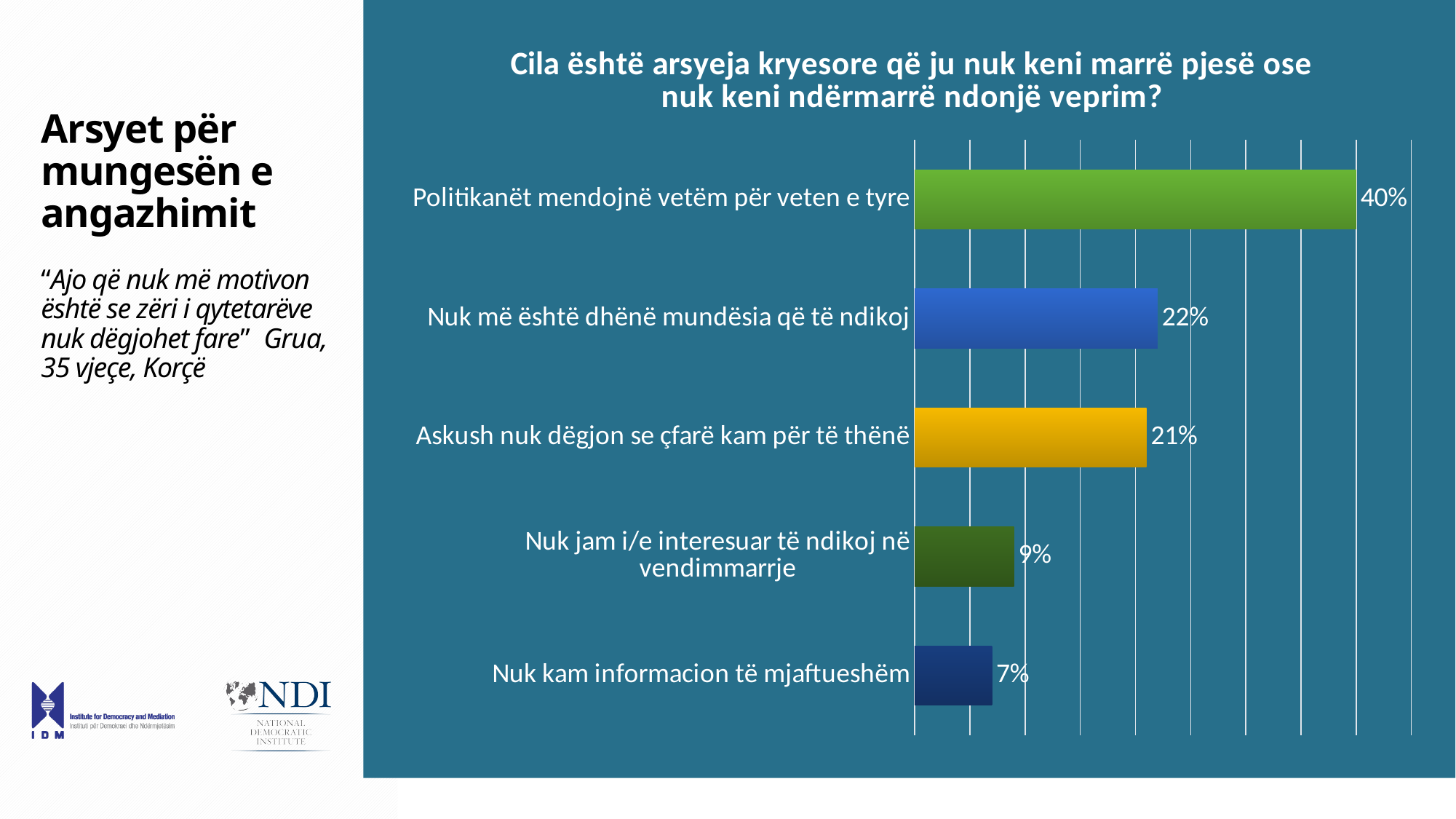
What is the value for "Nuk kam informacion të mjaftueshëm"? 7% Which is larger: the value for "Nuk jam i/e interesuar të ndikoj në vendimmarrje" or the value for "Nuk kam informacion të mjaftueshëm"? Nuk jam i/e interesuar të ndikoj në vendimmarrje What is the difference between the values for "Politikanët mendojnë vetëm për veten e tyre" and "Nuk më është dhënë mundësia që të ndikoj"? 18% What is the value for "Politikanët mendojnë vetëm për veten e tyre"? 40% What kind of chart is shown on the slide? Bar chart Which category has the highest value? Politikanët mendojnë vetëm për veten e tyre What is the value for "Nuk jam i/e interesuar të ndikoj në vendimmarrje"? 9% Which category has the lowest value? Nuk kam informacion të mjaftueshëm How many categories are shown in the chart? 5 What is the value for "Nuk më është dhënë mundësia që të ndikoj"? 22% What is the value for "Askush nuk dëgjon se çfarë kam për të thënë"? 21% What is the title of the chart? Cila është arsyeja kryesore që ju nuk keni marrë pjesë ose nuk keni ndërmarrë ndonjë veprim?